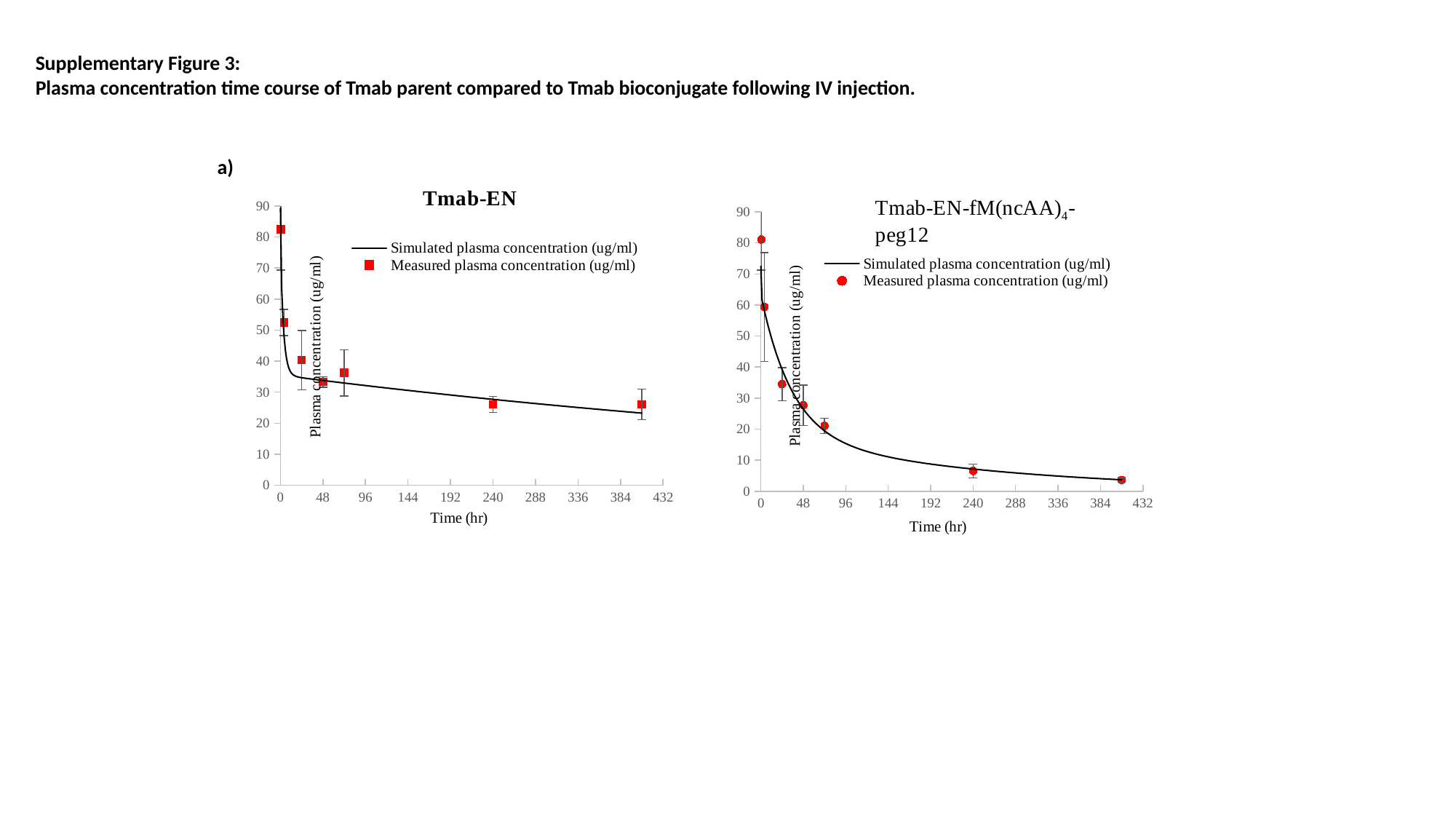
In the Tmab-EN chart, is the measured plasma concentration at the last time point (around 408 hr) greater or less than 20? greater In the Tmab-EN-fM(ncAA)4-peg12 chart, is the measured plasma concentration at 240 hr greater or less than 10? less What kind of chart is the Tmab-EN chart? line chart What marker shape is used for the measured plasma concentration in the Tmab-EN-fM(ncAA)4-peg12 chart? red circles In the Tmab-EN-fM(ncAA)4-peg12 chart, do the plotted values rise or fall along the x axis? fall At 240 hr, which chart shows the higher measured plasma concentration, Tmab-EN or Tmab-EN-fM(ncAA)4-peg12? Tmab-EN What is the x-axis label of the Tmab-EN chart? Time (hr) How many measured plasma concentration points are plotted in the Tmab-EN chart? 7 How many series does the legend of the Tmab-EN-fM(ncAA)4-peg12 chart list? 2 In the Tmab-EN chart, is the measured plasma concentration at 240 hr greater or less than 30? less In the Tmab-EN chart, do the plotted values rise or fall as time increases? fall